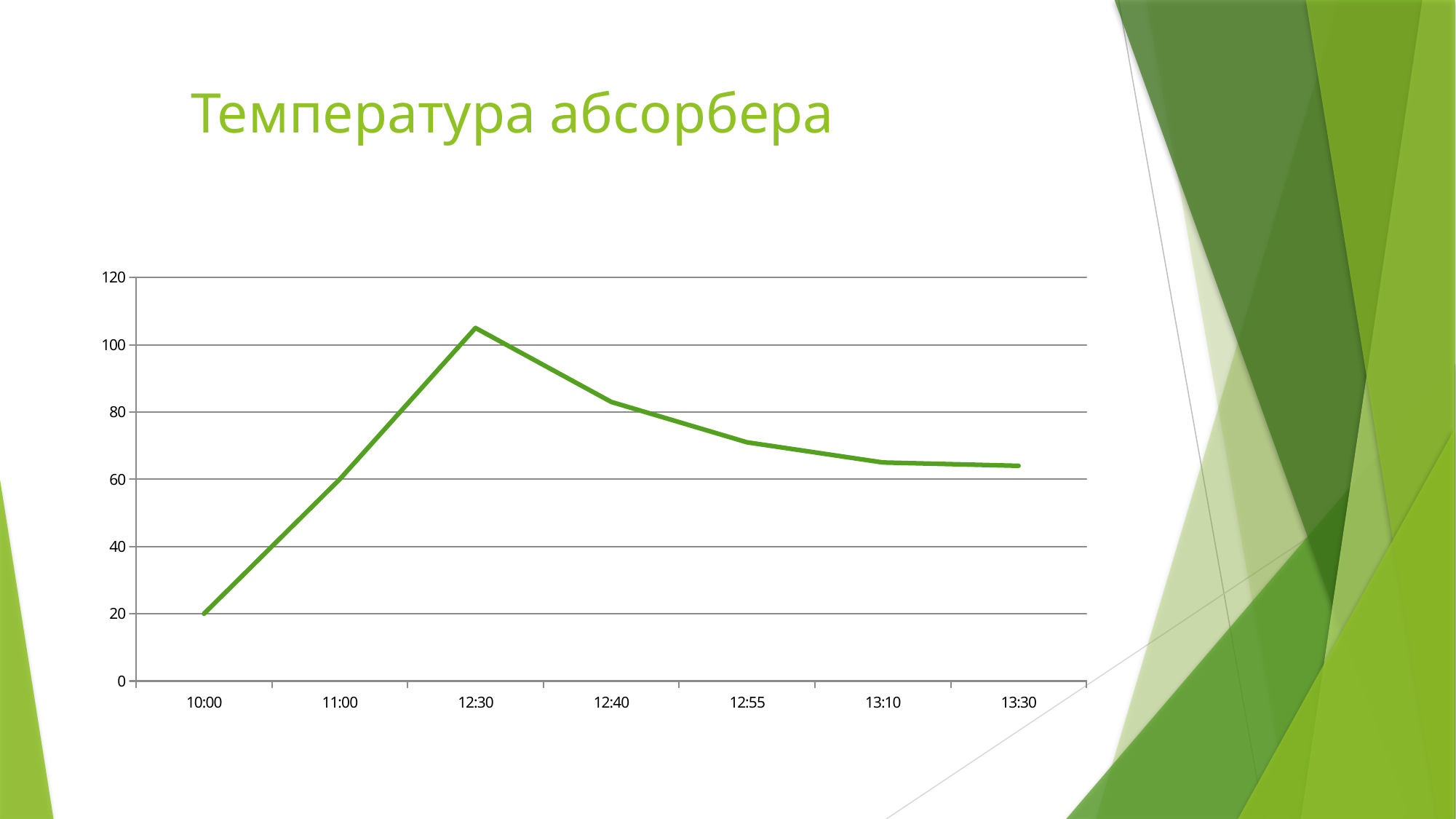
Is the value at 12:55 greater or less than 80? less What kind of chart is shown on the slide? line chart Is the value at 12:30 greater or less than 100? greater Which is larger, the value at 12:40 or the value at 13:10? 12:40 At which time is the temperature lowest? 10:00 How does the temperature change from 12:30 to 13:30? it falls Is the value at 11:00 greater or less than 40? greater What is the value at 10:00? 20 How many time points are plotted along the x axis? 7 What is the title of the chart on the slide? Температура абсорбера At which time is the temperature highest? 12:30